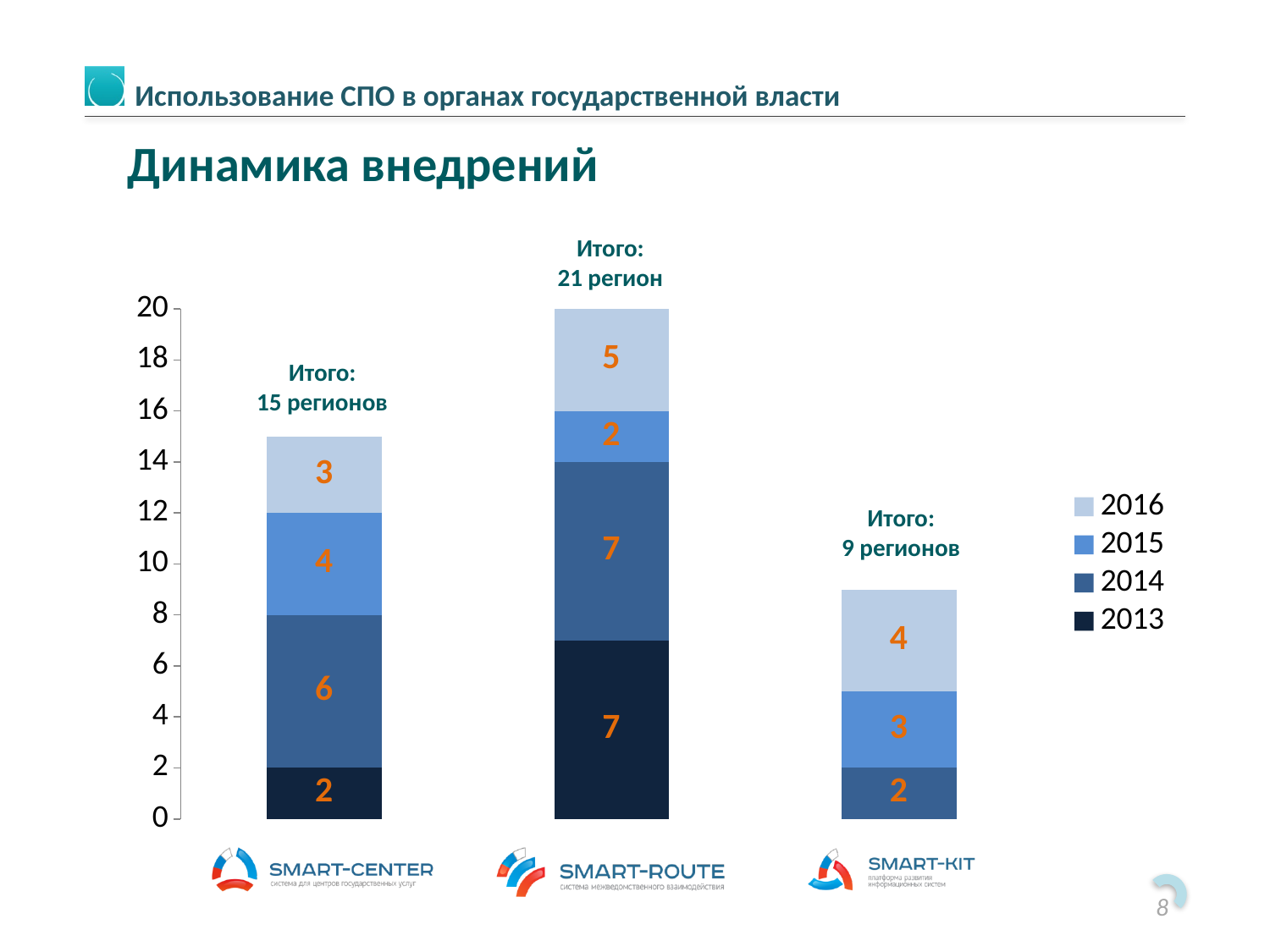
Which is larger: the 2016 value for SMART-KIT or the 2016 value for SMART-CENTER? SMART-KIT How many series does the legend list? 4 What is the 2016 value for SMART-ROUTE? 5 Which product has the lowest total? SMART-KIT What is the total shown for the SMART-KIT bar? 9 регионов What is the difference between the 2013 values for SMART-ROUTE and SMART-CENTER? 5 What kind of chart is shown on the slide? Stacked bar chart What is the 2015 value for SMART-KIT? 3 Which product has the highest total? SMART-ROUTE How many bars (products) are shown in the chart? 3 What is the total shown for the SMART-ROUTE bar? 21 регион What is the 2014 value for SMART-CENTER? 6